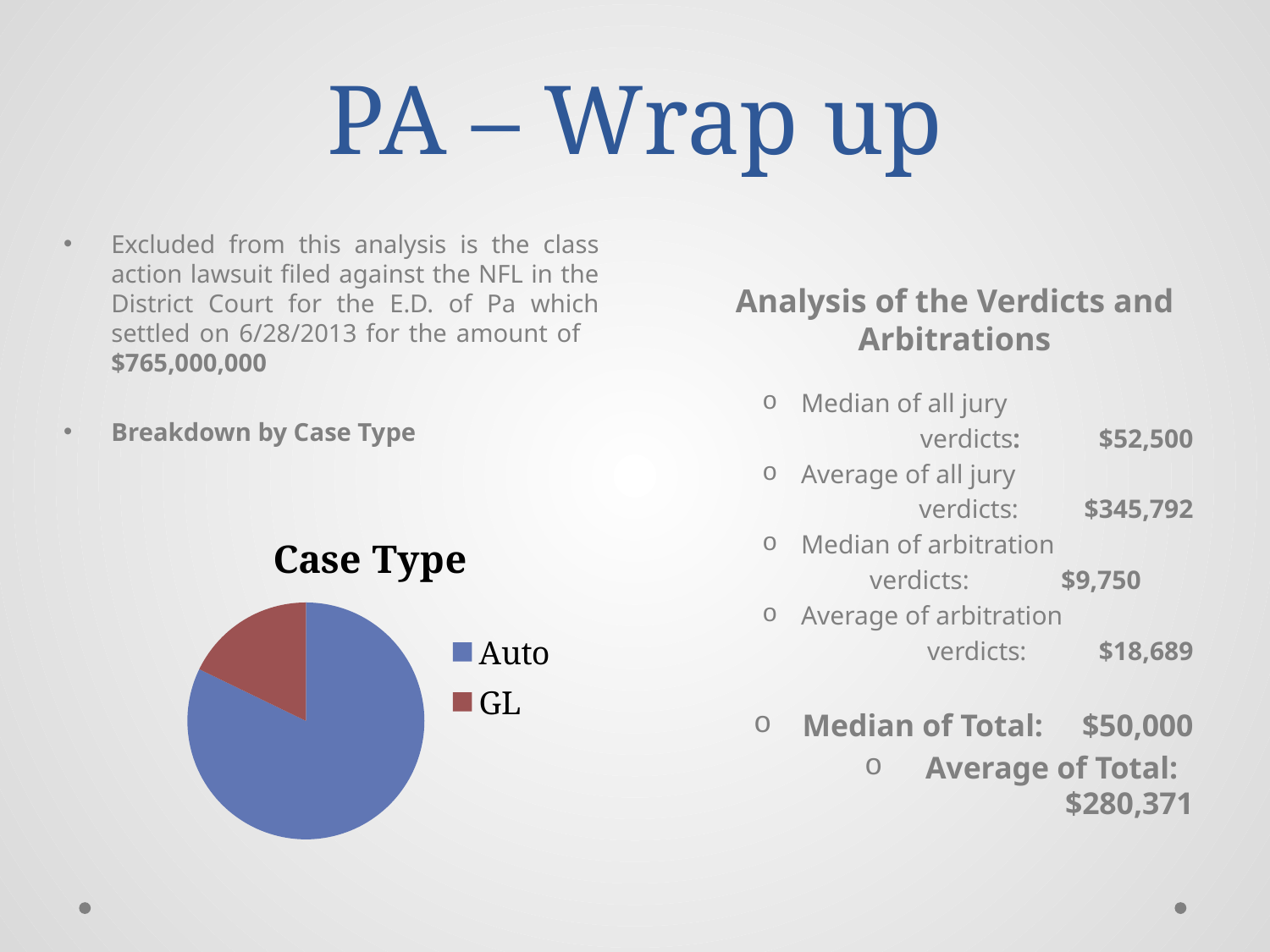
What is the title of the chart? Case Type How many slices does the pie chart have? 2 Which case type has the largest slice of the pie? Auto How many entries does the chart's legend list? 2 Which case type has the smallest slice of the pie? GL What colour is the Auto slice in the pie chart? Blue Does the Auto slice make up more or less than half of the pie? More What kind of chart is shown on the slide? Pie chart Which slice is larger, Auto or GL? Auto